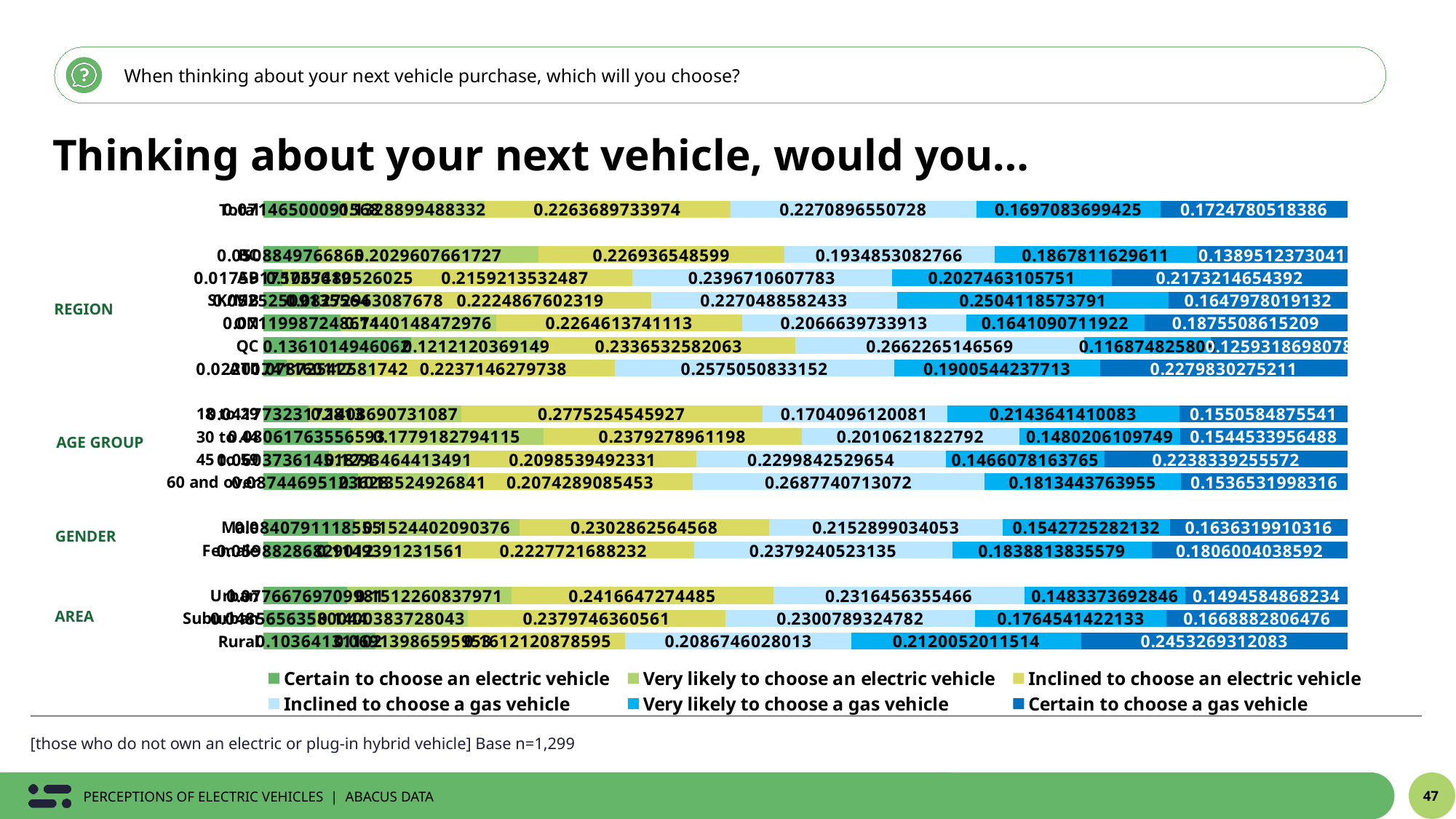
What is the value for 'Certain to choose a gas vehicle' in the Total row? 0.1724780518386 What is the first entry in the chart's legend? Certain to choose an electric vehicle What is the value for 'Inclined to choose a gas vehicle' in the QC row? 0.2662265146569 Which has the larger value for 'Inclined to choose a gas vehicle', QC or Total? QC What is the value for 'Certain to choose a gas vehicle' in the QC row? 0.1259318698078 What is the value for 'Very likely to choose a gas vehicle' in the Total row? 0.1697083699425 Which has the larger value for 'Certain to choose a gas vehicle', Rural or Total? Rural What is the value for 'Inclined to choose a gas vehicle' in the Total row? 0.2270896550728 What kind of chart is shown on the slide? bar chart What is the value for 'Certain to choose a gas vehicle' in the Rural row? 0.2453269312083 How many series does the legend list? 6 What is the value for 'Very likely to choose a gas vehicle' in the Rural row? 0.2120052011514